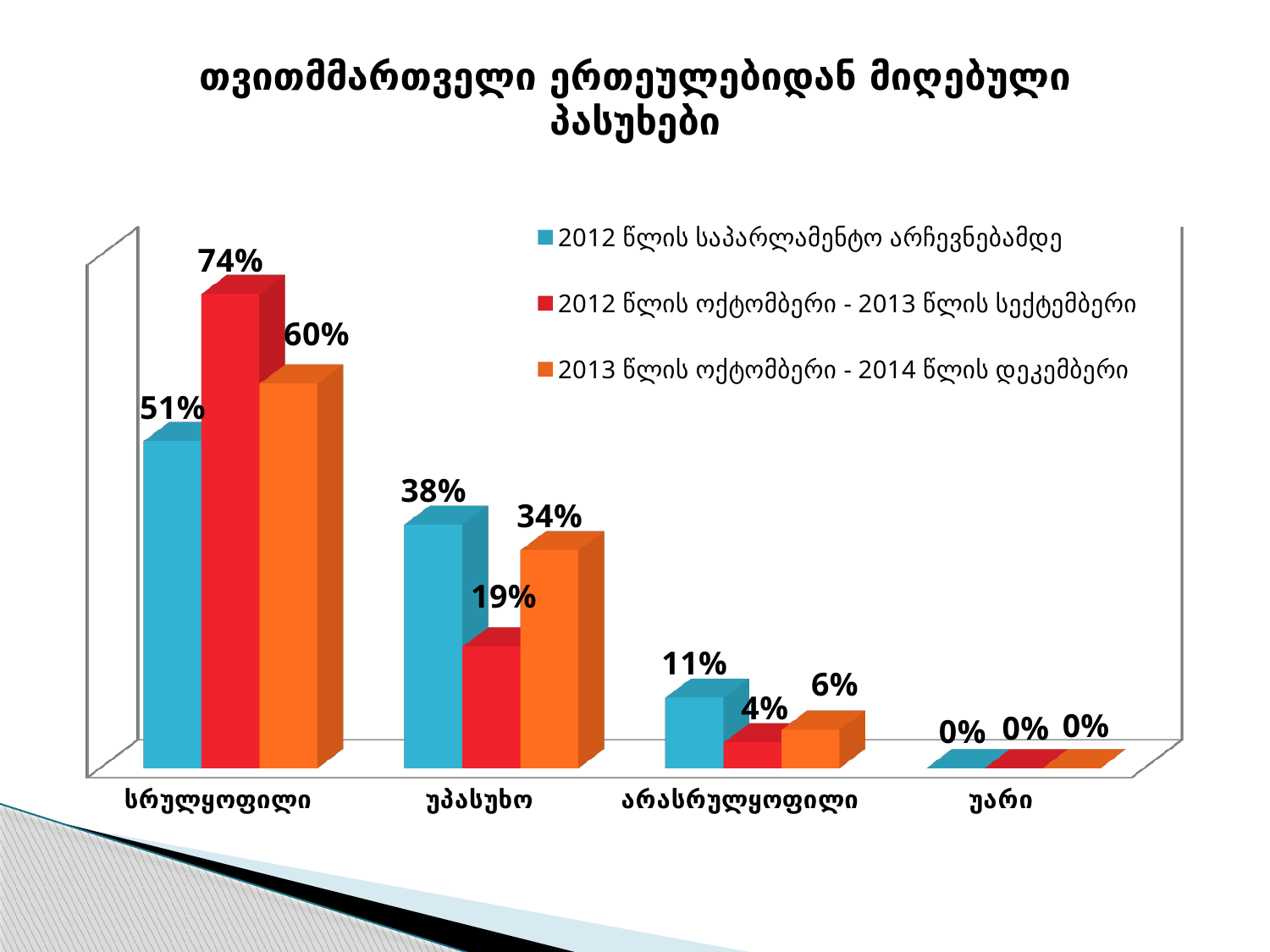
What colour are the bars for the series 2012 წლის საპარლამენტო არჩევნებამდე? blue What is the difference between the 2012 წლის ოქტომბერი - 2013 წლის სექტემბერი value and the 2012 წლის საპარლამენტო არჩევნებამდე value for სრულყოფილი? 23% What is the value for უარი in all three series? 0% Which category has the highest value in the series 2013 წლის ოქტომბერი - 2014 წლის დეკემბერი? სრულყოფილი What is the value for არასრულყოფილი in the series 2013 წლის ოქტომბერი - 2014 წლის დეკემბერი? 6% What is the value for სრულყოფილი in the series 2012 წლის ოქტომბერი - 2013 წლის სექტემბერი? 74% What type of chart is shown on the slide? bar chart Which category has the lowest value in the series 2012 წლის საპარლამენტო არჩევნებამდე? უარი How many series does the legend list? 3 For უპასუხო, which series has the larger value: 2012 წლის ოქტომბერი - 2013 წლის სექტემბერი or 2013 წლის ოქტომბერი - 2014 წლის დეკემბერი? 2013 წლის ოქტომბერი - 2014 წლის დეკემბერი What is the value for უპასუხო in the series 2012 წლის საპარლამენტო არჩევნებამდე? 38% How many categories are shown on the x axis? 4